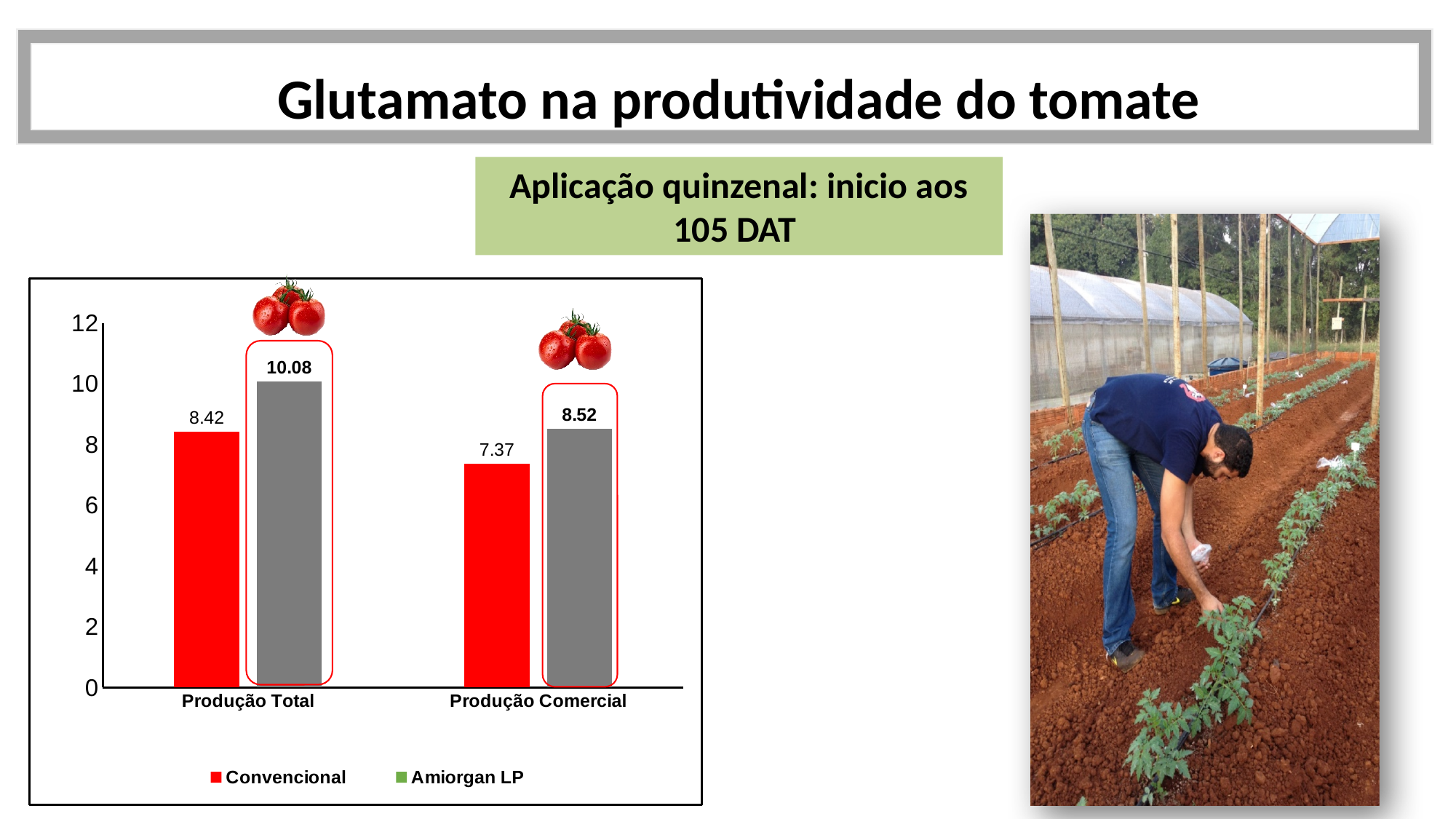
What is the value for Convencional in the Produção Comercial category? 7.37 What is the value for Amiorgan LP in the Produção Total category? 10.08 Which bar has the lowest value on the chart? Convencional, Produção Comercial What is the difference between Amiorgan LP and Convencional in the Produção Comercial category? 1.15 What is the value for Convencional in the Produção Total category? 8.42 What kind of chart is shown on the slide? Bar chart Which is larger in the Produção Comercial category, Convencional or Amiorgan LP? Amiorgan LP How many categories are shown on the x axis of the chart? 2 What is the value for Amiorgan LP in the Produção Comercial category? 8.52 How many series does the chart legend list? 2 Which bar has the highest value on the chart? Amiorgan LP, Produção Total What is the difference between Amiorgan LP and Convencional in the Produção Total category? 1.66